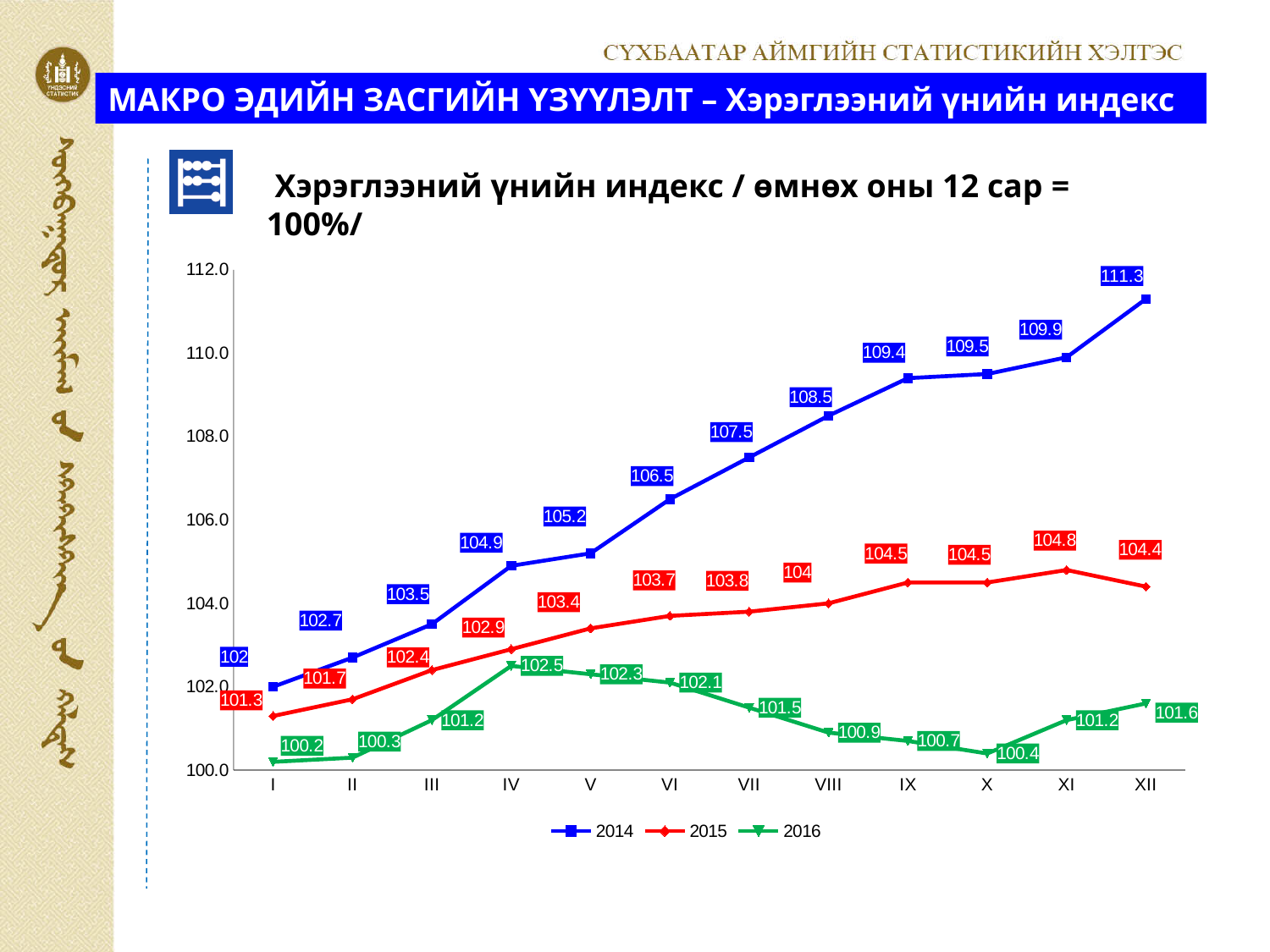
How many series does the legend list? 3 In which month does the 2016 series reach its lowest value? I Which colour is used for the 2016 series? green What type of chart is shown on the slide? line chart What is the difference between the 2014 value in month XII and the 2014 value in month I? 9.3 What is the value for 2016 in month IV? 102.5 Does the 2014 series rise or fall from month I to month XII? rise Which is larger in month VIII: the 2015 value or the 2016 value? 2015 What is the value for 2015 in month V? 103.4 What is the value for 2014 in month XII? 111.3 How many months are plotted along the x axis? 12 In which month does the 2015 series reach its highest value? XI